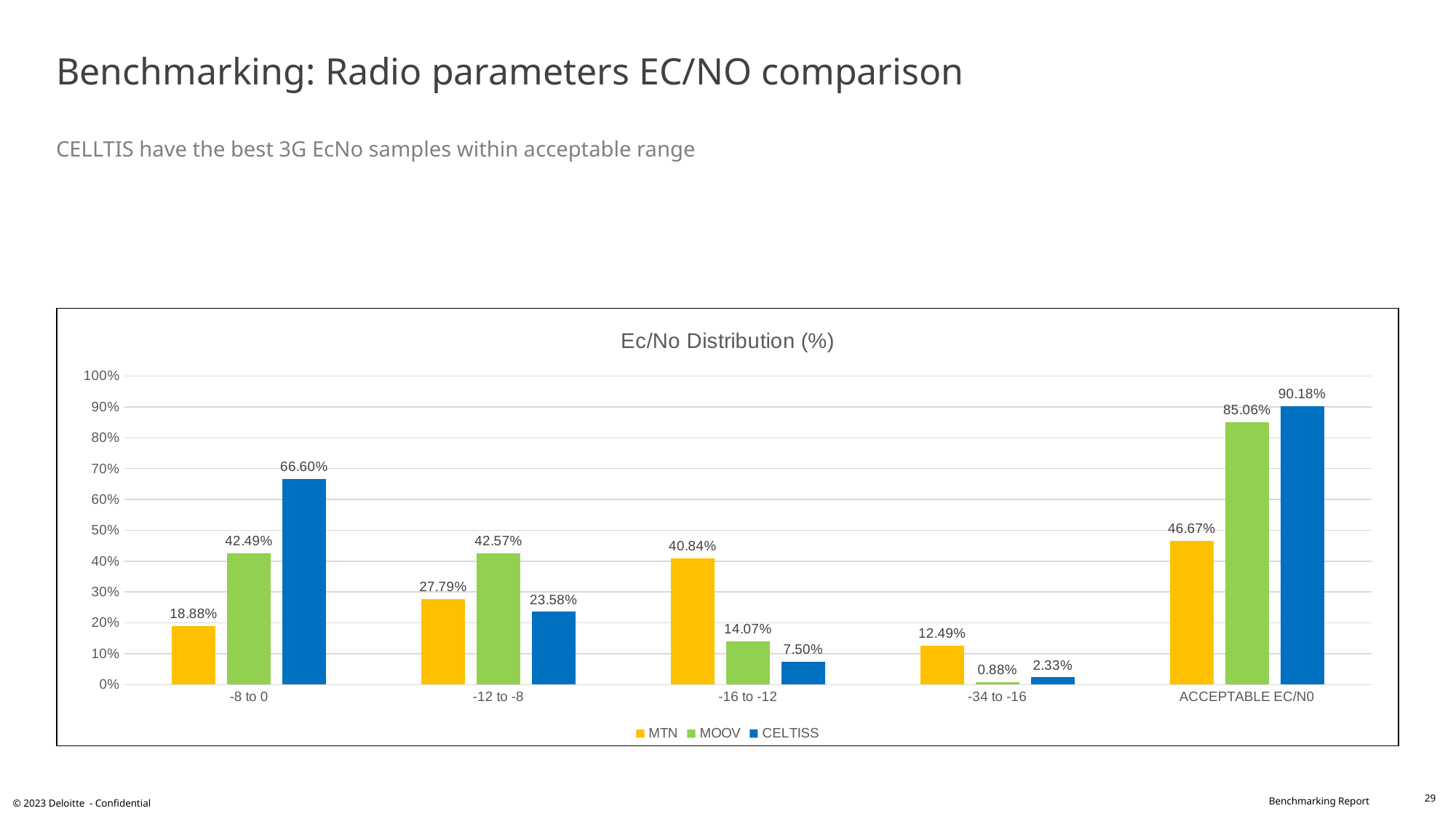
What kind of chart is shown on the slide? Bar chart What is the title of the chart? Ec/No Distribution (%) How many series does the legend list? 3 Is the value for MTN in the -16 to -12 category greater or less than 30%? greater What is the value for MOOV in the -34 to -16 category? 0.88% What is the value for MTN in the ACCEPTABLE EC/N0 category? 46.67% How many categories are shown on the x axis? 5 Which series has the highest value in the ACCEPTABLE EC/N0 category? CELTISS Which is larger in the -12 to -8 category, the MTN value or the MOOV value? MOOV What is the value for CELTISS in the -8 to 0 category? 66.60% What is the difference between the CELTISS and MOOV values in the ACCEPTABLE EC/N0 category? 5.12% Which series has the lowest value in the -16 to -12 category? CELTISS